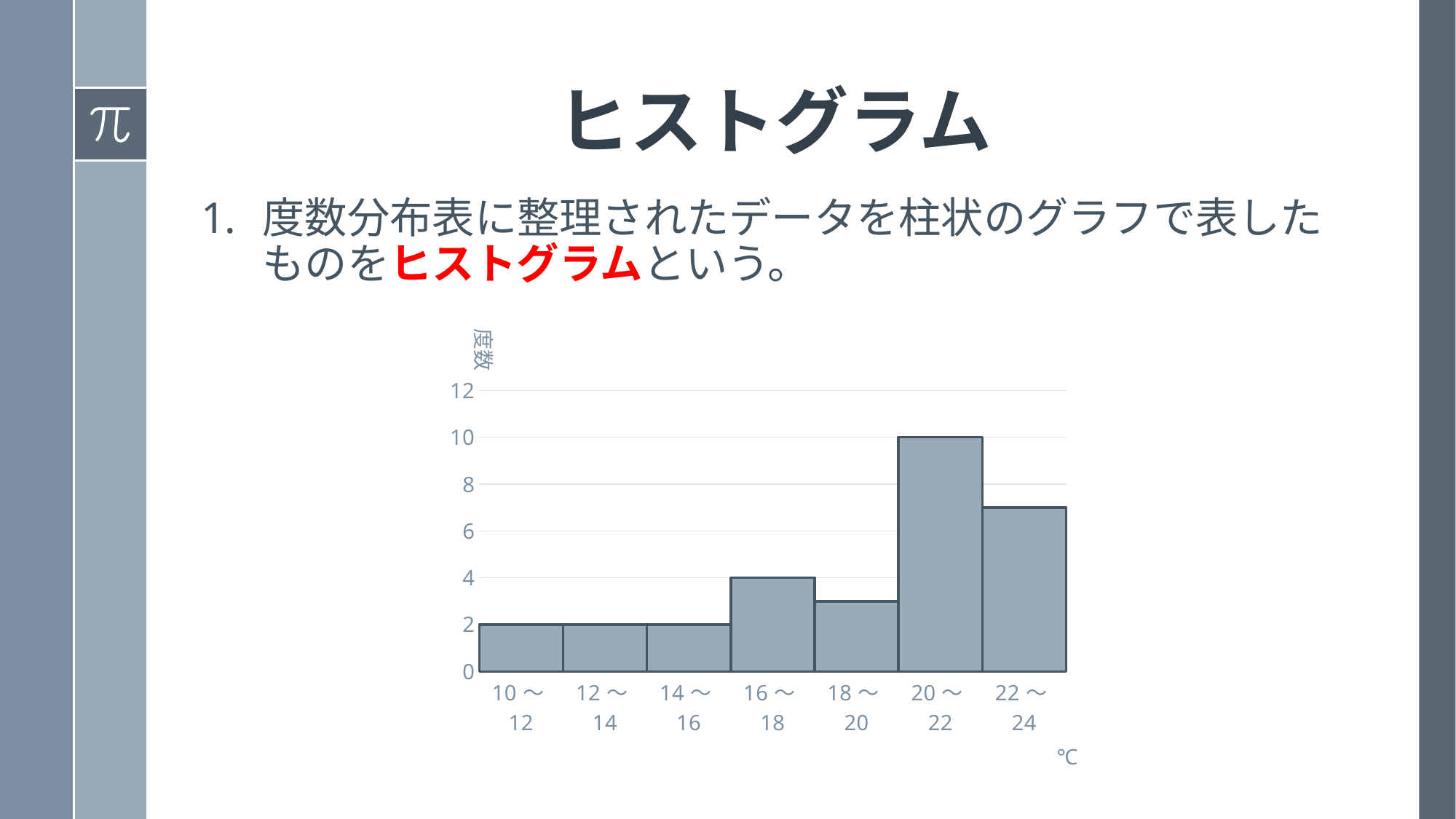
What is the difference between the frequency of the 20～22 class and the 16～18 class? 6 What is the frequency for the 16～18 ℃ class? 4 Which temperature class has the highest frequency? 20～22 How many temperature classes (bars) are shown in the chart? 7 What is the frequency (度数) for the 20～22 ℃ class? 10 What unit is shown for the horizontal axis? ℃ Which has a larger frequency, the 20～22 class or the 22～24 class? 20～22 What kind of chart is shown on the slide? bar chart (histogram) Is the frequency for the 22～24 class greater or less than 8? less What is the label of the vertical axis? 度数 Is the frequency for the 18～20 class greater or less than 2? greater What is the frequency for the 10～12 ℃ class? 2